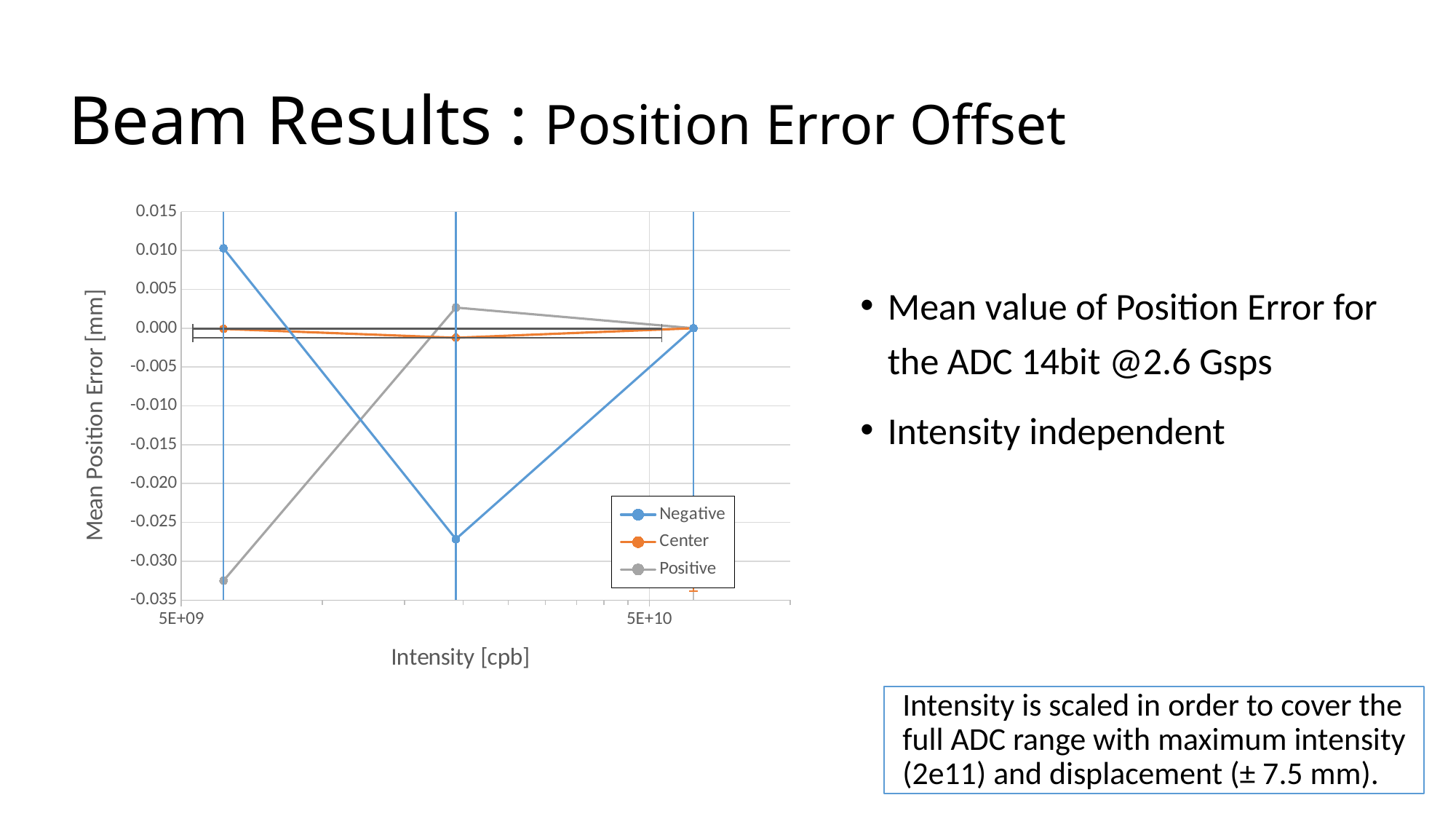
How many data points does the Negative series have? 3 How many series does the legend list? 3 Does the Negative series rise or fall between the lowest and the middle intensity points? Fall Which series reaches the lowest value anywhere on the chart? Positive Is the value of the Negative series at the middle intensity greater or less than -0.020? less Is the value of the Positive series at the middle intensity greater or less than 0.000? greater What is the title of the y axis? Mean Position Error [mm] Is the value of the Positive series at the lowest intensity greater or less than -0.030? less What kind of chart is shown on the slide? Line chart At the lowest intensity, which series has the larger value, Negative or Positive? Negative What is the title of the x axis? Intensity [cpb]